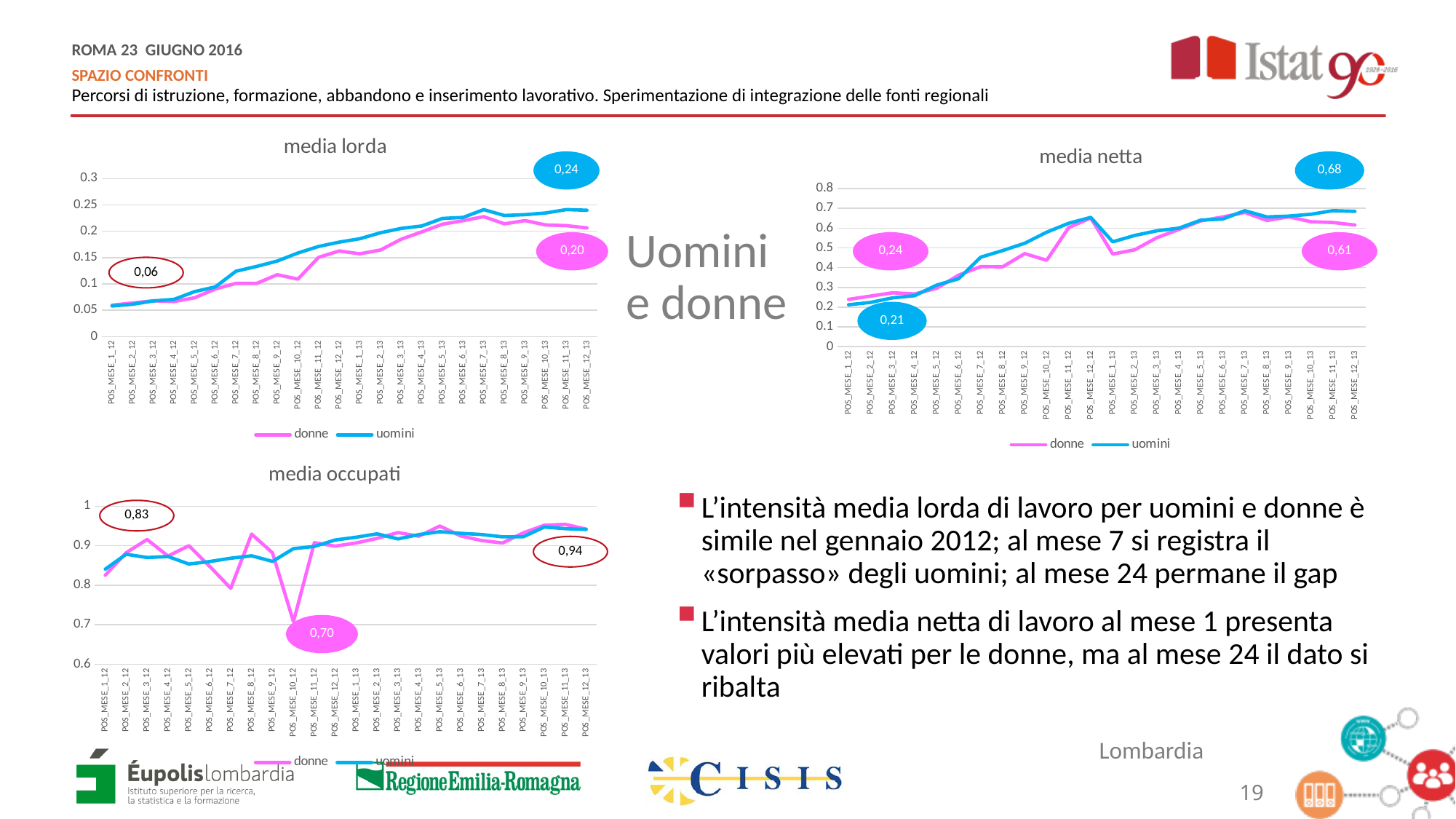
In the "media occupati" chart, is the value for uomini at POS_MESE_12_13 greater or less than 0.9? greater In the "media occupati" chart, what value is labelled at the low point of the donne line around POS_MESE_10_12? 0,70 How many series does the legend of the "media netta" chart list? 2 In the "media netta" chart, what is the difference between the labelled end values for uomini (0,68) and donne (0,61)? 0,07 In the "media lorda" chart, what value is labelled for donne at the end of the series? 0,20 In the "media netta" chart, what value is labelled for donne at the end of the series? 0,61 In the "media netta" chart, which series has the higher labelled value at the start of the series, donne (0,24) or uomini (0,21)? donne In the "media lorda" chart, do the values generally rise or fall from POS_MESE_1_12 to POS_MESE_12_13? rise What kind of chart is the "media lorda" chart? line chart In the "media lorda" chart, what value is labelled for uomini at the end of the series? 0,24 How many months (x-axis points) are plotted in the "media occupati" chart? 24 In the "media netta" chart, what value is labelled for uomini at the end of the series? 0,68